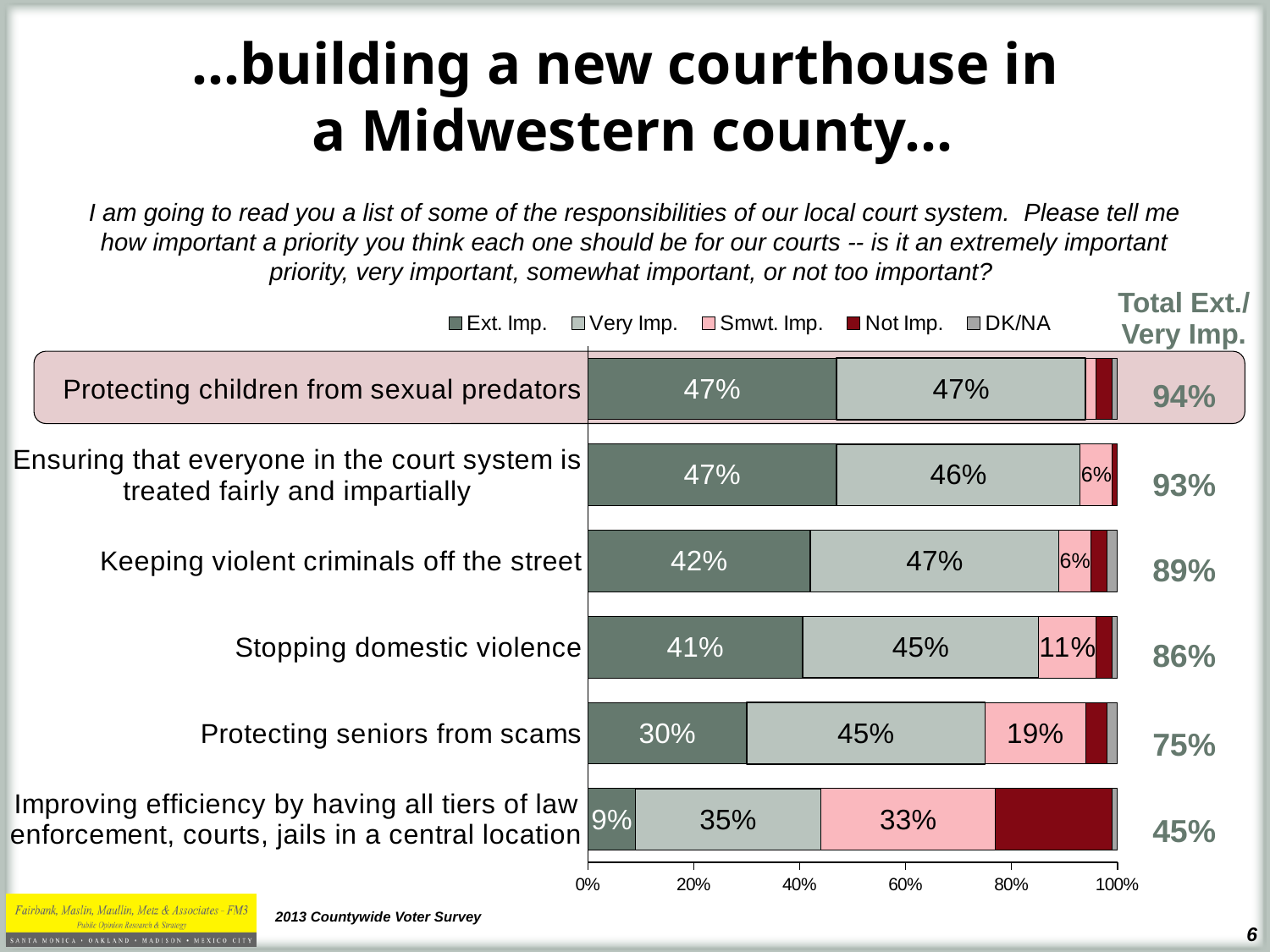
What percentage rated 'Protecting children from sexual predators' as Ext. Imp.? 47% What is the Smwt. Imp. value for 'Stopping domestic violence'? 11% How many percentage points higher is the Ext. Imp. value for 'Keeping violent criminals off the street' than for 'Protecting seniors from scams'? 12 percentage points Is the Not Imp. value for 'Improving efficiency by having all tiers of law enforcement, courts, jails in a central location' greater or less than 10%? greater What type of chart is shown on the slide? Stacked bar chart What is the Very Imp. value for 'Protecting seniors from scams'? 45% Which item has the lowest Total Ext./Very Imp. value? Improving efficiency by having all tiers of law enforcement, courts, jails in a central location Which has the larger Smwt. Imp. value: 'Protecting seniors from scams' or 'Stopping domestic violence'? Protecting seniors from scams How many series does the legend list? 5 What is the Ext. Imp. value for 'Improving efficiency by having all tiers of law enforcement, courts, jails in a central location'? 9% How many court responsibilities are listed in the chart? 6 Which item has the highest Total Ext./Very Imp. value? Protecting children from sexual predators